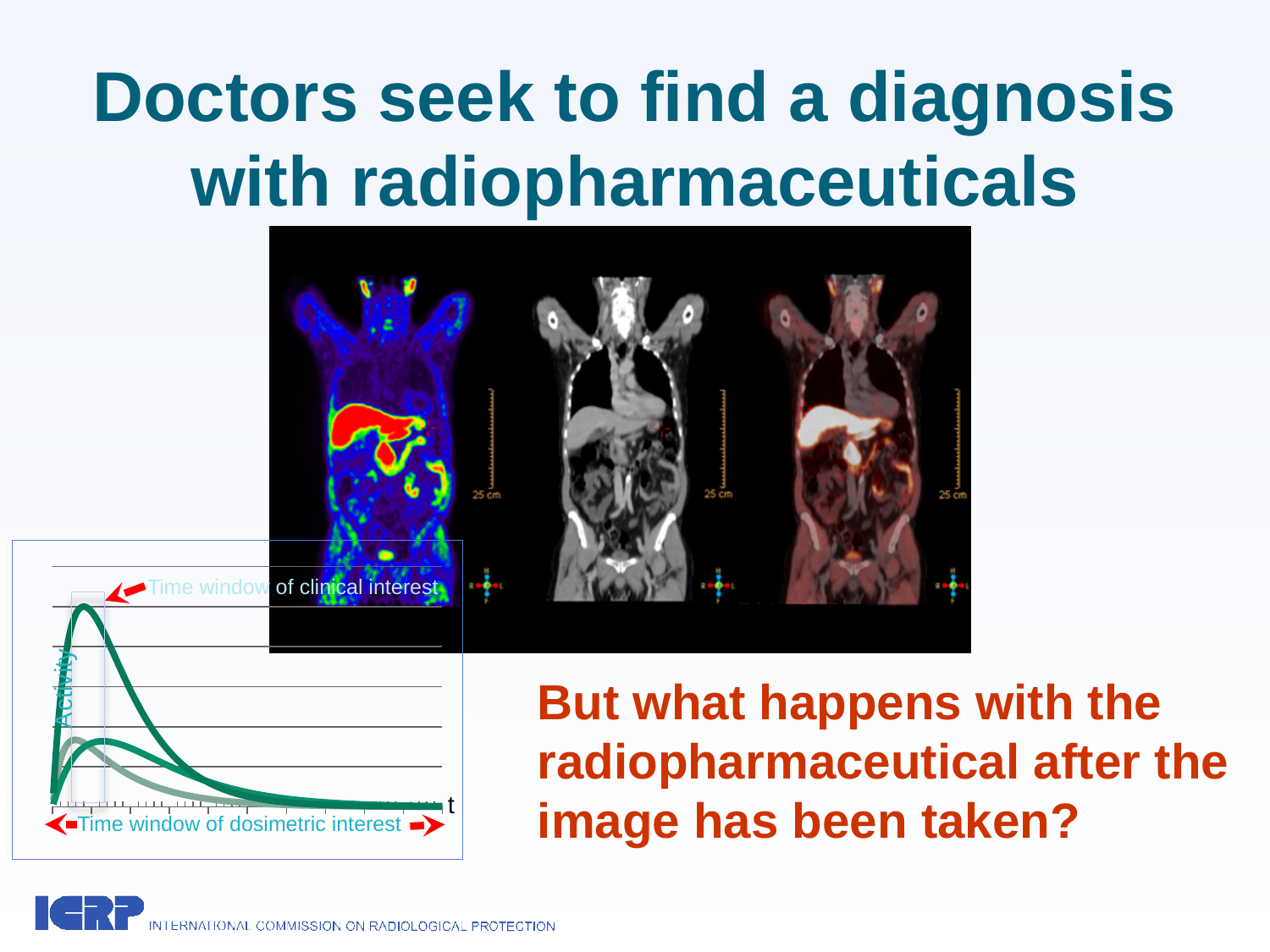
What is the label on the horizontal axis of the chart? t What is the label on the vertical axis of the chart? Activity How many curves are plotted on the Activity chart? 3 Which curve reaches the higher peak on the Activity chart, the dark green one or the light green one? the dark green one Which time window is marked near the peak of the curves at the top of the chart? Time window of clinical interest After reaching their peak, do the curves on the Activity chart rise or fall as t increases? fall What kind of chart is shown in the bottom-left of the slide? line chart